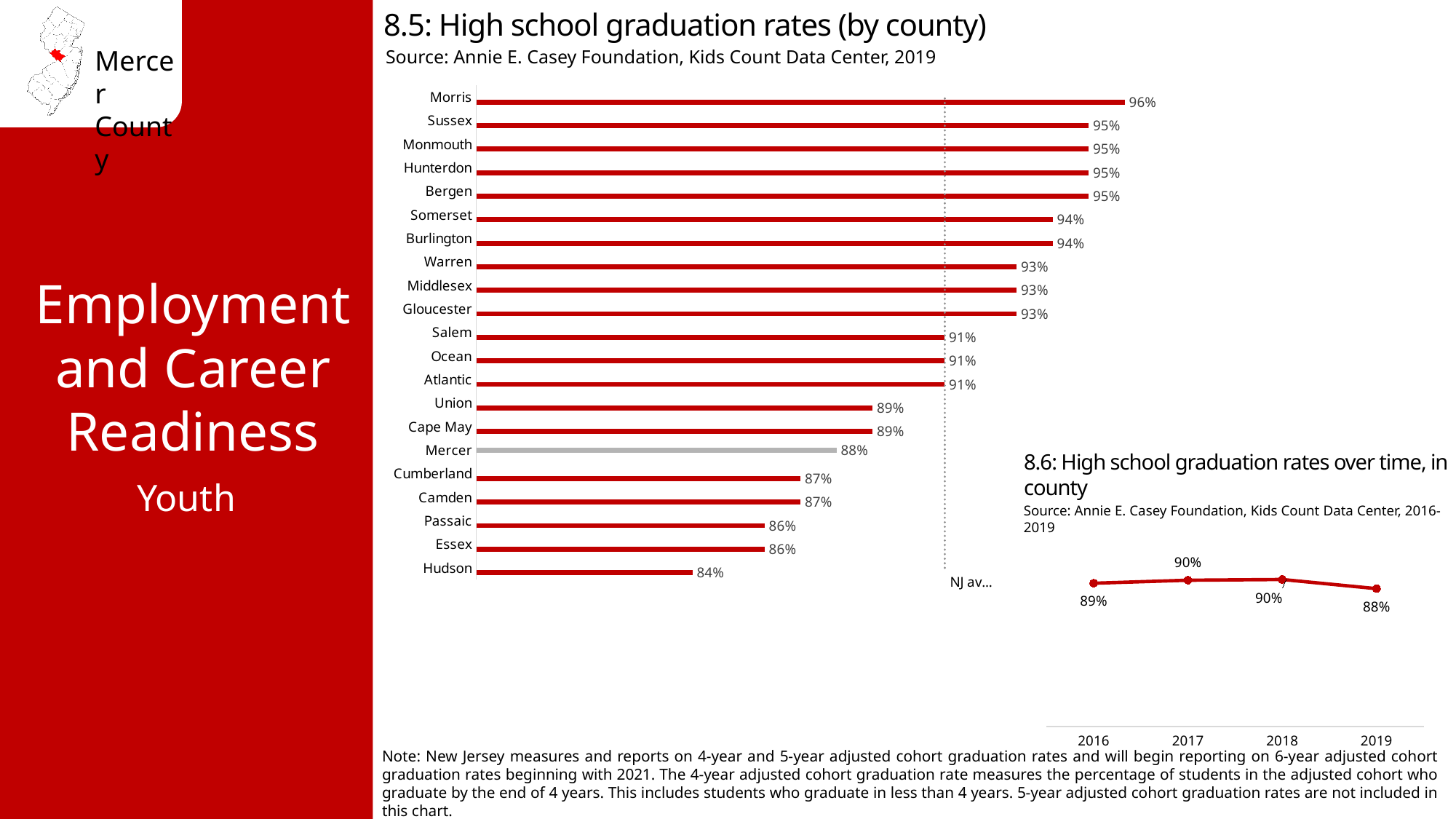
In chart 8.6 (High school graduation rates over time, in county), what is the graduation rate for 2019? 88% In chart 8.5 (High school graduation rates by county), which county has the highest graduation rate? Morris In chart 8.5 (High school graduation rates by county), what is the difference between the graduation rates of Morris and Mercer? 8% In chart 8.5 (High school graduation rates by county), what is the graduation rate for Hudson? 84% In chart 8.5 (High school graduation rates by county), which county has the lowest graduation rate? Hudson What kind of chart is chart 8.5 (High school graduation rates by county)? Bar chart In chart 8.6 (High school graduation rates over time, in county), what is the difference between the 2017 and 2019 graduation rates? 2% In chart 8.5 (High school graduation rates by county), how many counties are shown? 21 In chart 8.5 (High school graduation rates by county), which county's bar is coloured grey instead of red? Mercer In chart 8.6 (High school graduation rates over time, in county), how many years are plotted? 4 In chart 8.5 (High school graduation rates by county), which has a higher graduation rate, Union or Camden? Union In chart 8.5 (High school graduation rates by county), what is the graduation rate for Mercer? 88%